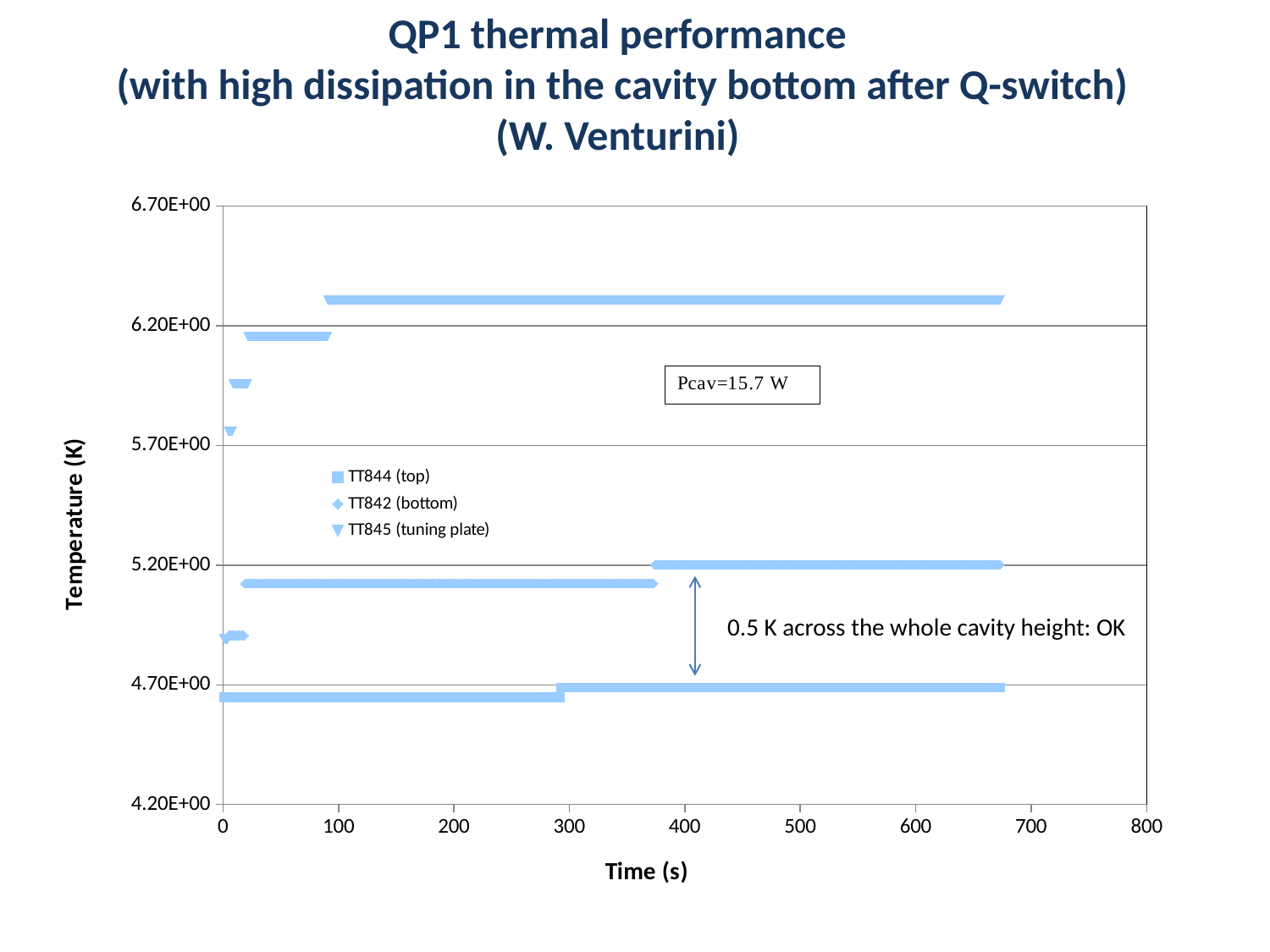
At 500 s, which is larger: the temperature of TT842 (bottom) or TT844 (top)? TT842 (bottom) How many series does the legend list? 3 Which series has the highest temperature over most of the time range? TT845 (tuning plate) What kind of chart is shown on the slide? scatter chart Does the TT845 (tuning plate) temperature rise or fall over the first 100 s? rise Is the value for TT845 (tuning plate) after 100 s greater or less than 6.20E+00? greater Is the value for TT844 (top) at 100 s greater or less than 5.20E+00? less Is the value for TT845 (tuning plate) at 0 s greater or less than 6.20E+00? less What is the title of the vertical axis? Temperature (K) What cavity power is stated in the box on the chart? Pcav=15.7 W Which series has the lowest temperature over the time range? TT844 (top)